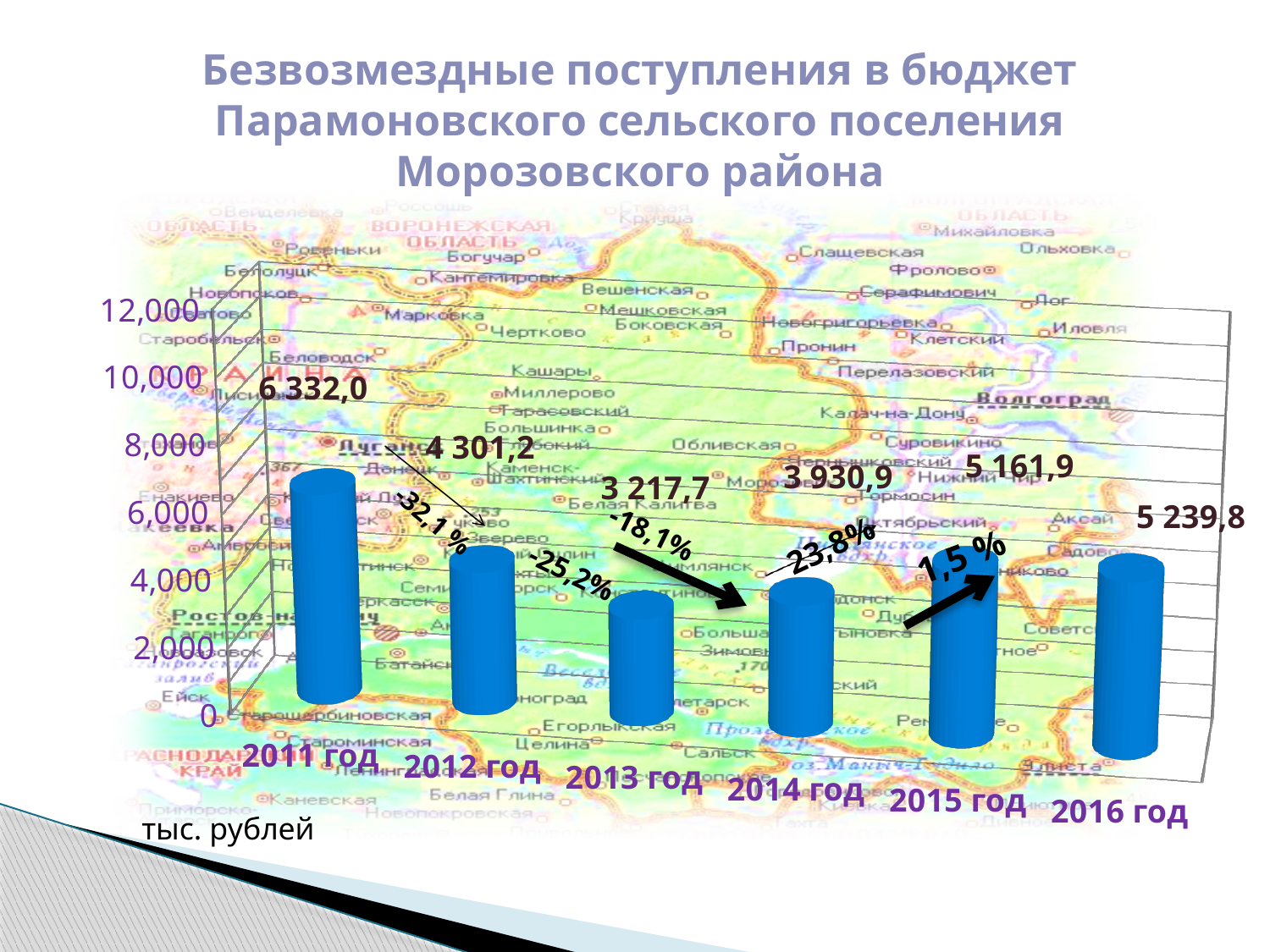
What is the difference between the values for 2011 год and 2012 год? 2 030,8 What is the difference between the values for 2016 год and 2015 год? 77,9 What is the value for 2011 год? 6 332,0 What is the value for 2013 год? 3 217,7 Do the values rise or fall from 2011 год to 2013 год? fall What kind of chart is shown on the slide? bar chart Which year has the lowest value? 2013 год How many years are shown on the chart? 6 What is the value for 2016 год? 5 239,8 Which is larger, the value for 2014 год or the value for 2015 год? 2015 год Which year has the highest value? 2011 год Is the value for 2011 год greater or less than 6,000? greater